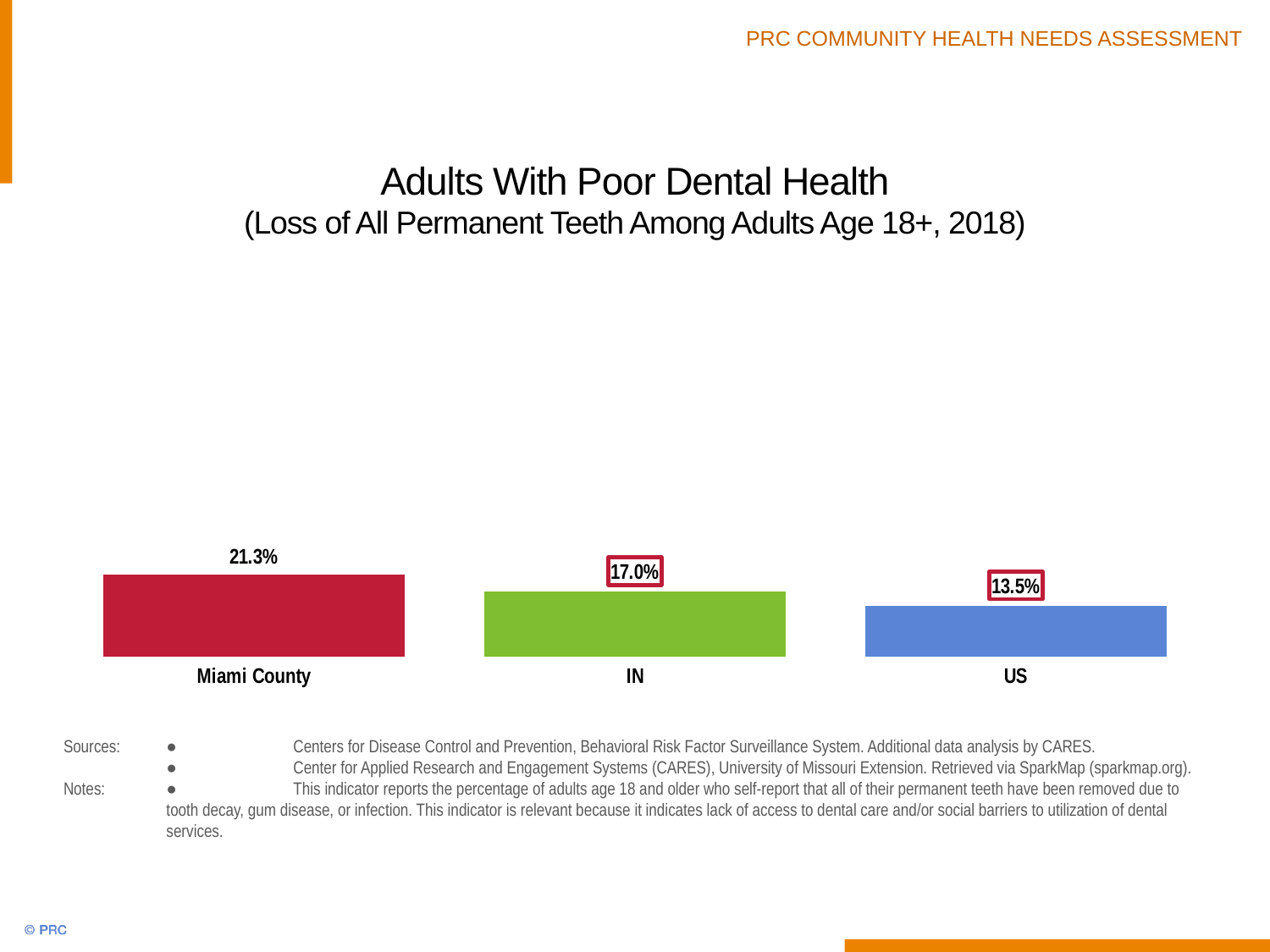
How many categories are shown in the chart? 3 What is the title of the chart? Adults With Poor Dental Health (Loss of All Permanent Teeth Among Adults Age 18+, 2018) What is the value for IN? 17.0% Which category has the lowest value? US Which is larger, the value for IN or the value for US? IN What is the difference between the Miami County value and the IN value? 4.3% What is the value for Miami County? 21.3% What is the difference between the Miami County value and the US value? 7.8% What kind of chart is shown on the slide? Bar chart Which category has the highest value? Miami County Do the values rise or fall from left to right across the categories? Fall What is the value for US? 13.5%